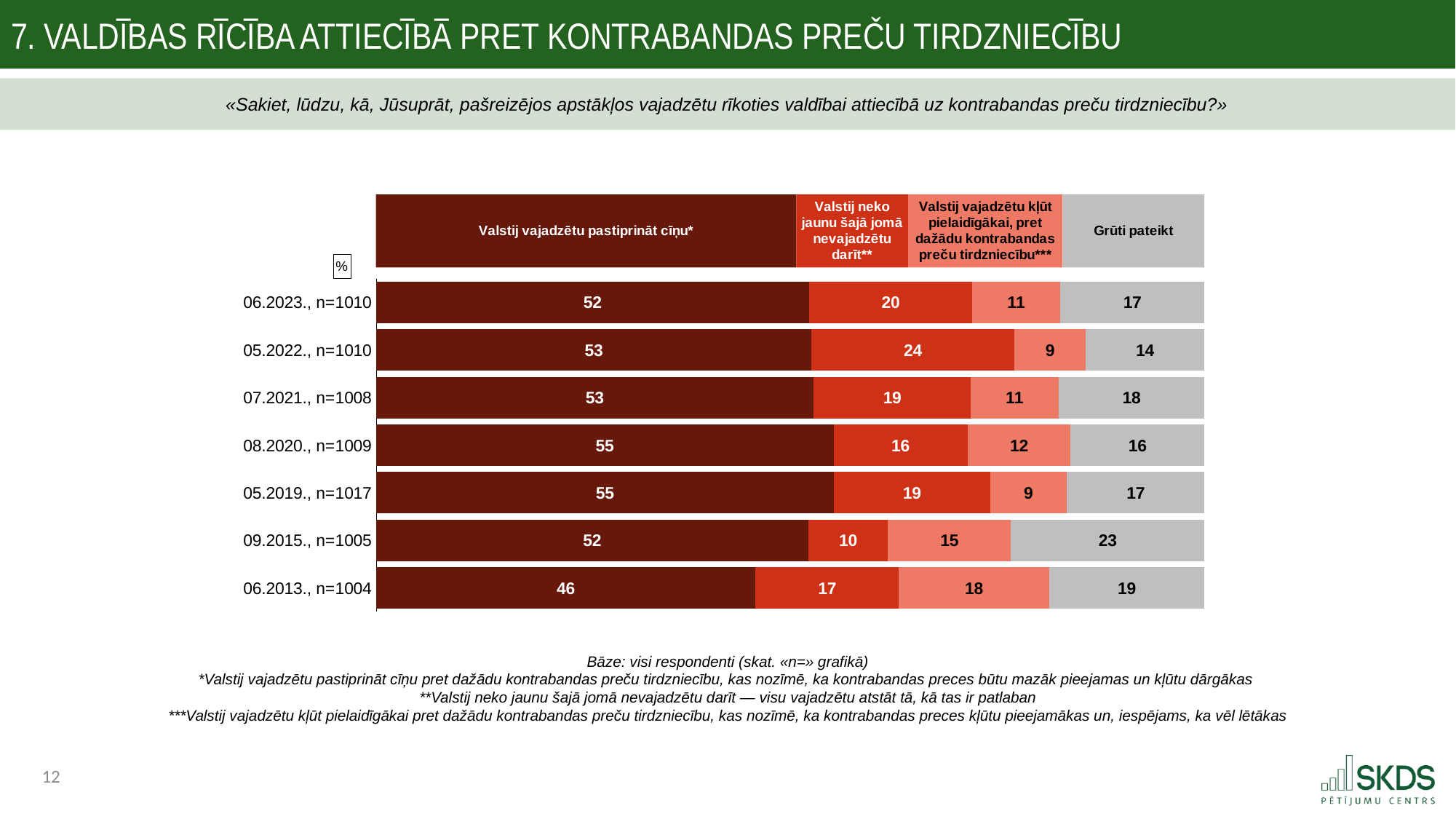
Which series is shown in grey in the chart? Grūti pateikt What kind of chart is shown on the slide? stacked bar chart Which is larger: the "Valstij vajadzētu kļūt pielaidīgākai...***" value in 06.2013., n=1004 or in 05.2022., n=1010? 06.2013., n=1004 In which survey wave is the value for "Valstij vajadzētu pastiprināt cīņu*" the lowest? 06.2013., n=1004 How many survey waves (rows) are shown in the chart? 7 What is the total of the stacked bar for 06.2023., n=1010? 100 What is the value for "Valstij neko jaunu šajā jomā nevajadzētu darīt**" in 05.2022., n=1010? 24 What is the value for "Valstij vajadzētu pastiprināt cīņu*" in 06.2023., n=1010? 52 In which survey wave is the value for "Grūti pateikt" the highest? 09.2015., n=1005 What is the value for "Grūti pateikt" in 09.2015., n=1005? 23 How many series does the chart legend list? 4 What is the difference between the "Valstij vajadzētu pastiprināt cīņu*" values for 08.2020., n=1009 and 06.2013., n=1004? 9